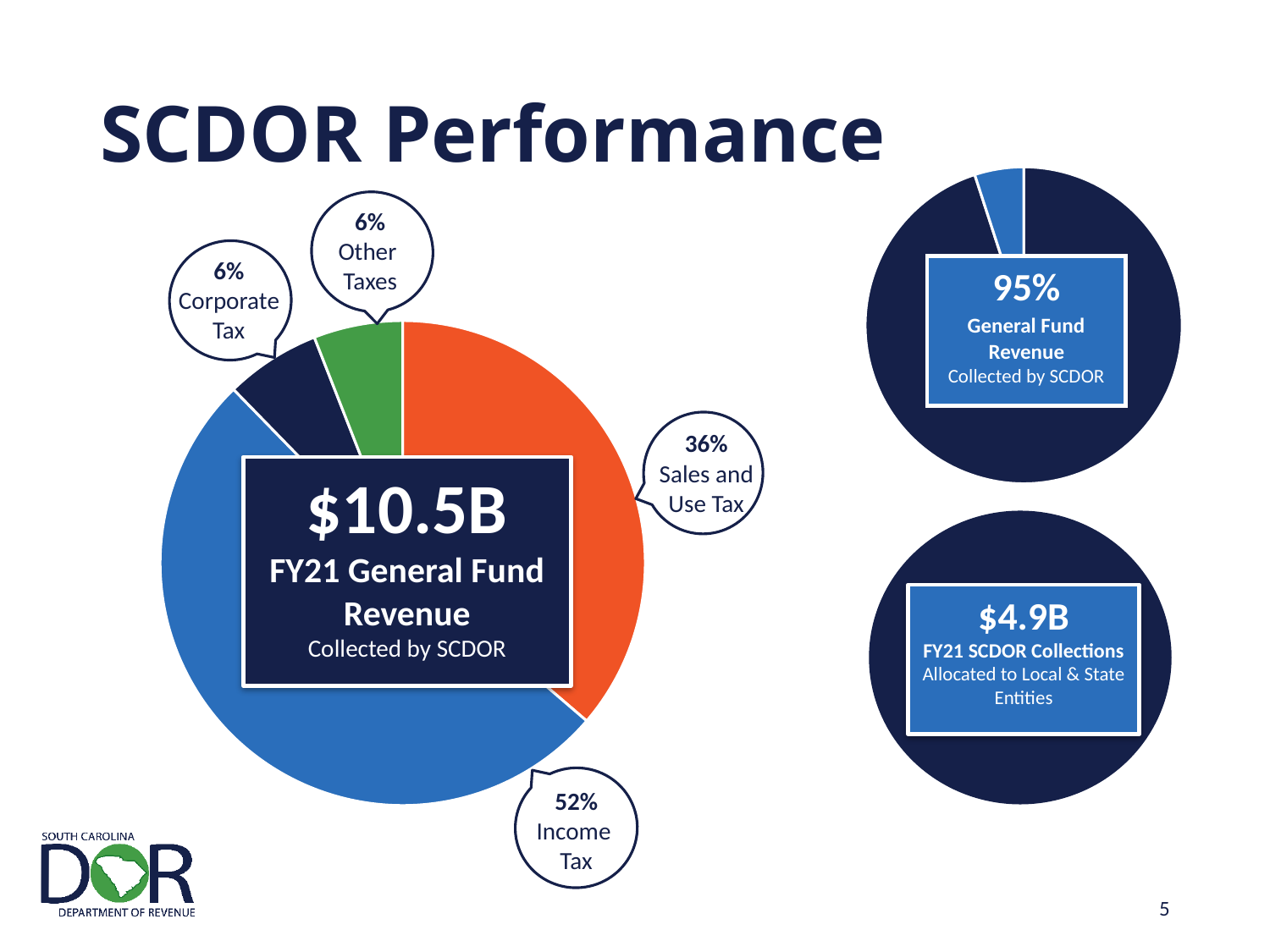
In the FY21 General Fund Revenue pie chart, what share is Sales and Use Tax? 36% What total value is shown in the centre of the FY21 General Fund Revenue pie chart? $10.5B In the small pie chart at the top right, what percentage of General Fund Revenue is collected by SCDOR? 95% In the FY21 General Fund Revenue pie chart, what share is Income Tax? 52% In the FY21 General Fund Revenue pie chart, which category has the largest slice? Income Tax In the FY21 General Fund Revenue pie chart, which is larger: Sales and Use Tax or Corporate Tax? Sales and Use Tax How many slices does the FY21 General Fund Revenue pie chart have? 4 In the FY21 General Fund Revenue pie chart, how many percentage points larger is Income Tax than Sales and Use Tax? 16% In the FY21 General Fund Revenue pie chart, what share is Corporate Tax? 6% What kind of chart is the large chart on the left of the slide? Pie chart In the FY21 General Fund Revenue pie chart, what share is Other Taxes? 6% In the FY21 General Fund Revenue pie chart, how many percentage points larger is Sales and Use Tax than Other Taxes? 30%